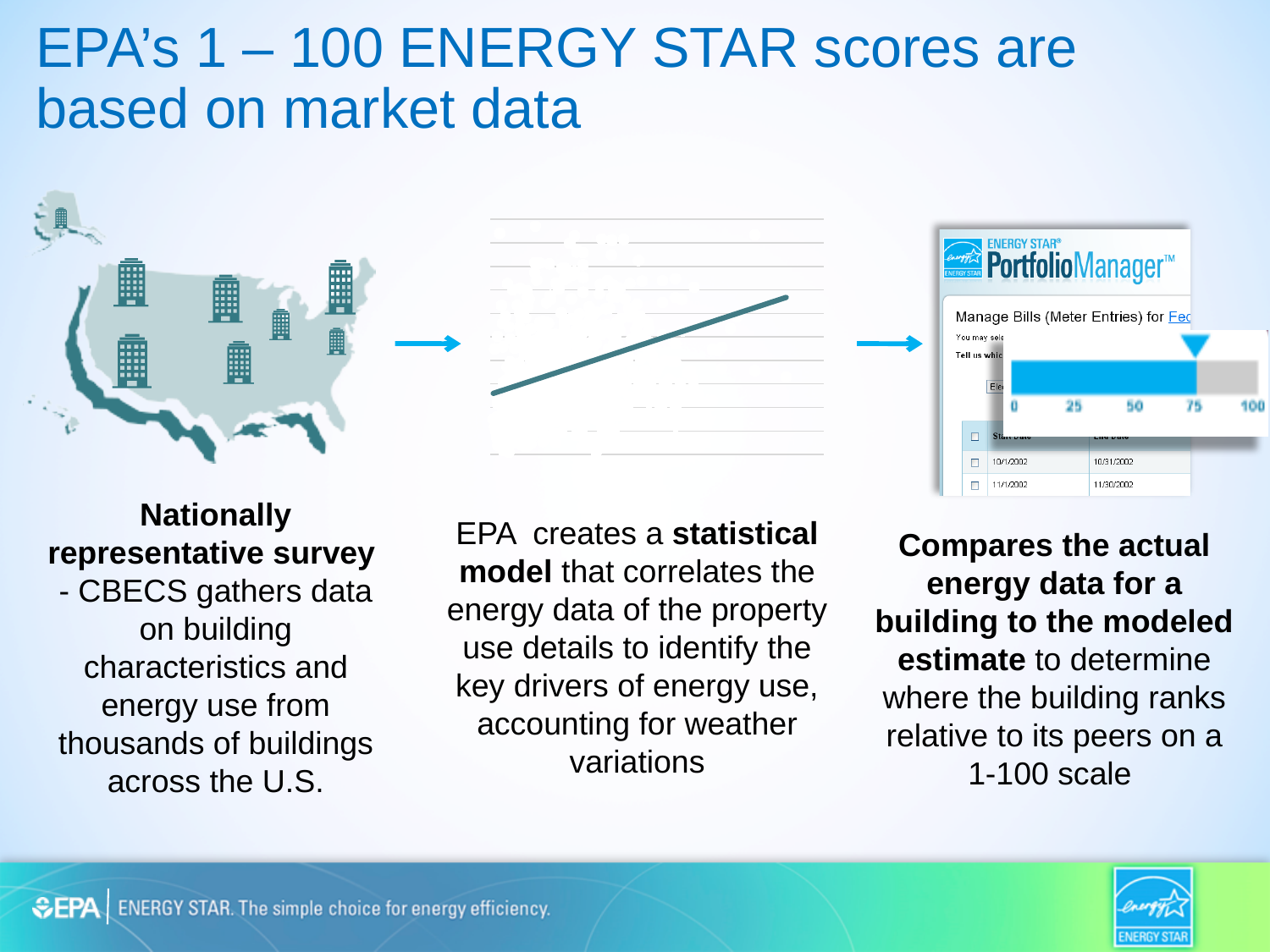
What kind of chart is shown in the middle of the slide, above the text about the statistical model? scatter chart with a trend line On the score bar in the Portfolio Manager screenshot on the right, is the marked score greater or less than 100? less On the score bar in the Portfolio Manager screenshot on the right, is the marked score greater or less than 50? greater On the score bar in the Portfolio Manager screenshot on the right, what score does the marker point to? 75 On the score bar in the Portfolio Manager screenshot on the right, what is the highest value shown on the scale? 100 What colour is the filled portion of the score bar in the Portfolio Manager screenshot on the right? blue How many tick labels are shown on the score bar in the Portfolio Manager screenshot on the right? 5 On the score bar in the Portfolio Manager screenshot on the right, what is the lowest value shown on the scale? 0 In the middle chart, does the trend line rise or fall from left to right? rises